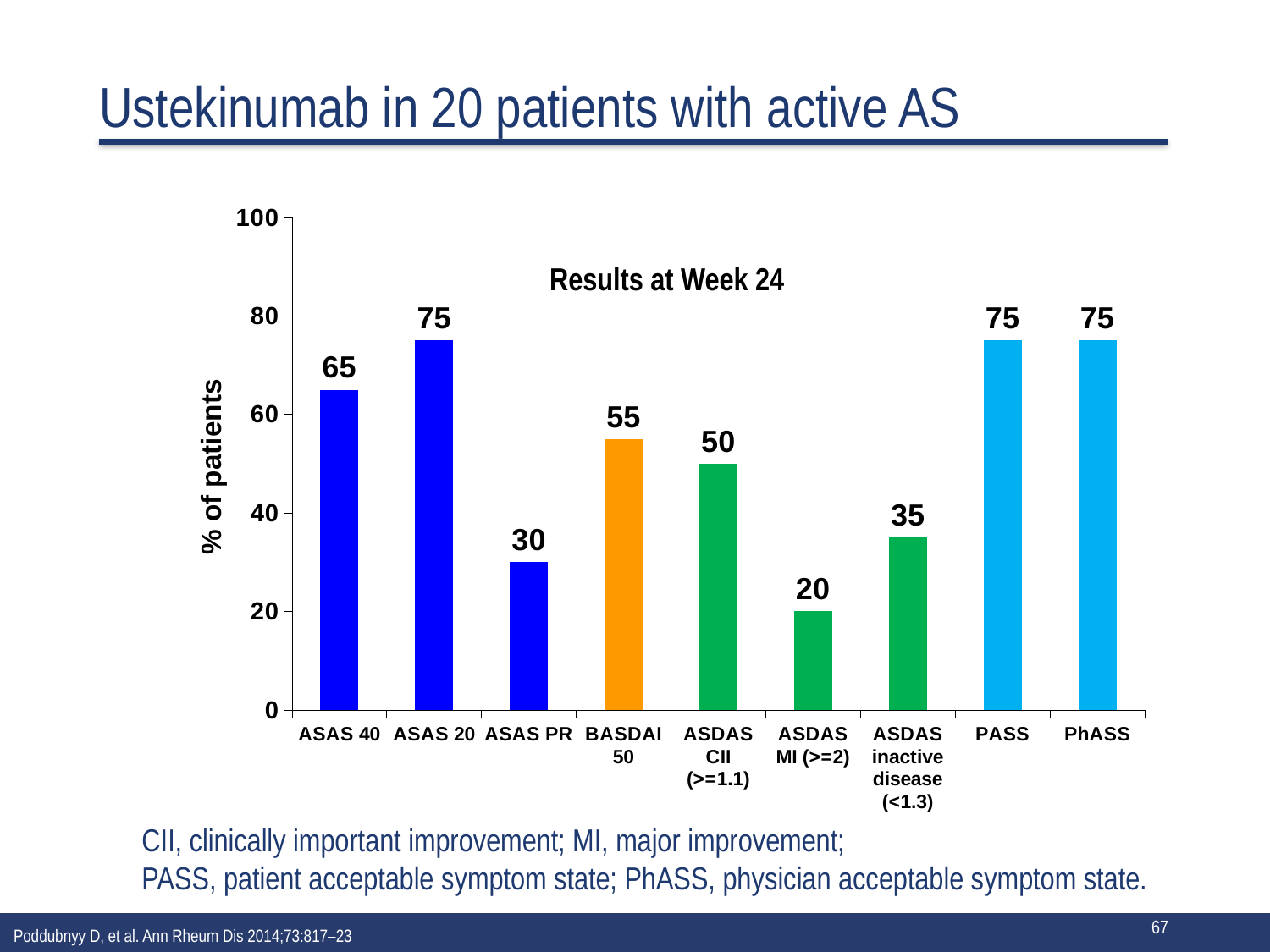
What is the value for BASDAI 50? 55 What is the label of the y axis? % of patients Which is larger, the value for ASAS 40 or the value for BASDAI 50? ASAS 40 Is the value for ASAS PR greater or less than 40? less What is the value for ASDAS inactive disease (<1.3)? 35 What type of chart is shown on the slide? bar chart Which category has the lowest value? ASDAS MI (>=2) What percentage of patients achieved ASAS 40 at Week 24? 65 What is the difference between the values for ASDAS CII (>=1.1) and ASDAS MI (>=2)? 30 What is the highest value shown on the chart? 75 How many categories are shown on the x axis? 9 What is the difference between the values for ASAS 20 and ASAS PR? 45